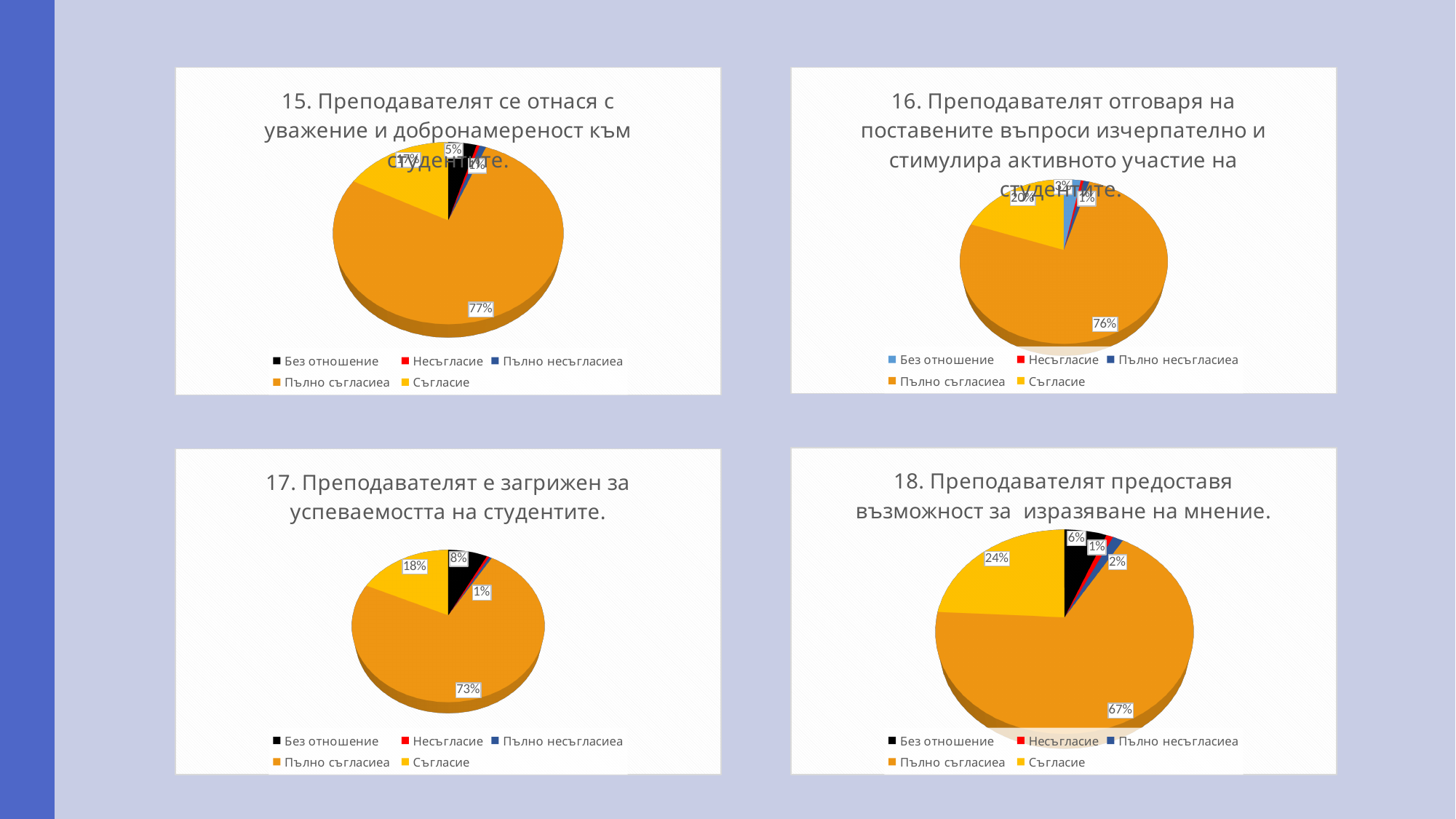
In the chart titled "15. Преподавателят се отнася с уважение и добронамереност към студентите.", what percentage is shown for the Съгласие slice? 17% How many entries does the legend list in the chart titled "15. Преподавателят се отнася с уважение и добронамереност към студентите."? 5 In the chart titled "15. Преподавателят се отнася с уважение и добронамереност към студентите.", what percentage is shown for the Пълно съгласиеа slice? 77% In the chart titled "18. Преподавателят предоставя възможност за изразяване на мнение.", what percentage is shown for the Съгласие slice? 24% In the chart titled "18. Преподавателят предоставя възможност за изразяване на мнение.", what is the difference in percentage points between the Пълно съгласиеа slice and the Съгласие slice? 43 In the chart titled "16. Преподавателят отговаря на поставените въпроси изчерпателно и стимулира активното участие на студентите.", what percentage is shown for the Пълно съгласиеа slice? 76% In the chart titled "17. Преподавателят е загрижен за успеваемостта на студентите.", what is the difference in percentage points between the Пълно съгласиеа slice and the Съгласие slice? 55 In the chart titled "17. Преподавателят е загрижен за успеваемостта на студентите.", which category has the largest slice? Пълно съгласиеа What kind of chart is the chart titled "18. Преподавателят предоставя възможност за изразяване на мнение."? Pie chart In the chart titled "17. Преподавателят е загрижен за успеваемостта на студентите.", what percentage is shown for the Без отношение slice? 8% In the chart titled "18. Преподавателят предоставя възможност за изразяване на мнение.", which is larger, the Без отношение slice or the Пълно несъгласиеа slice? Без отношение In the chart titled "16. Преподавателят отговаря на поставените въпроси изчерпателно и стимулира активното участие на студентите.", what percentage is shown for the Съгласие slice? 20%